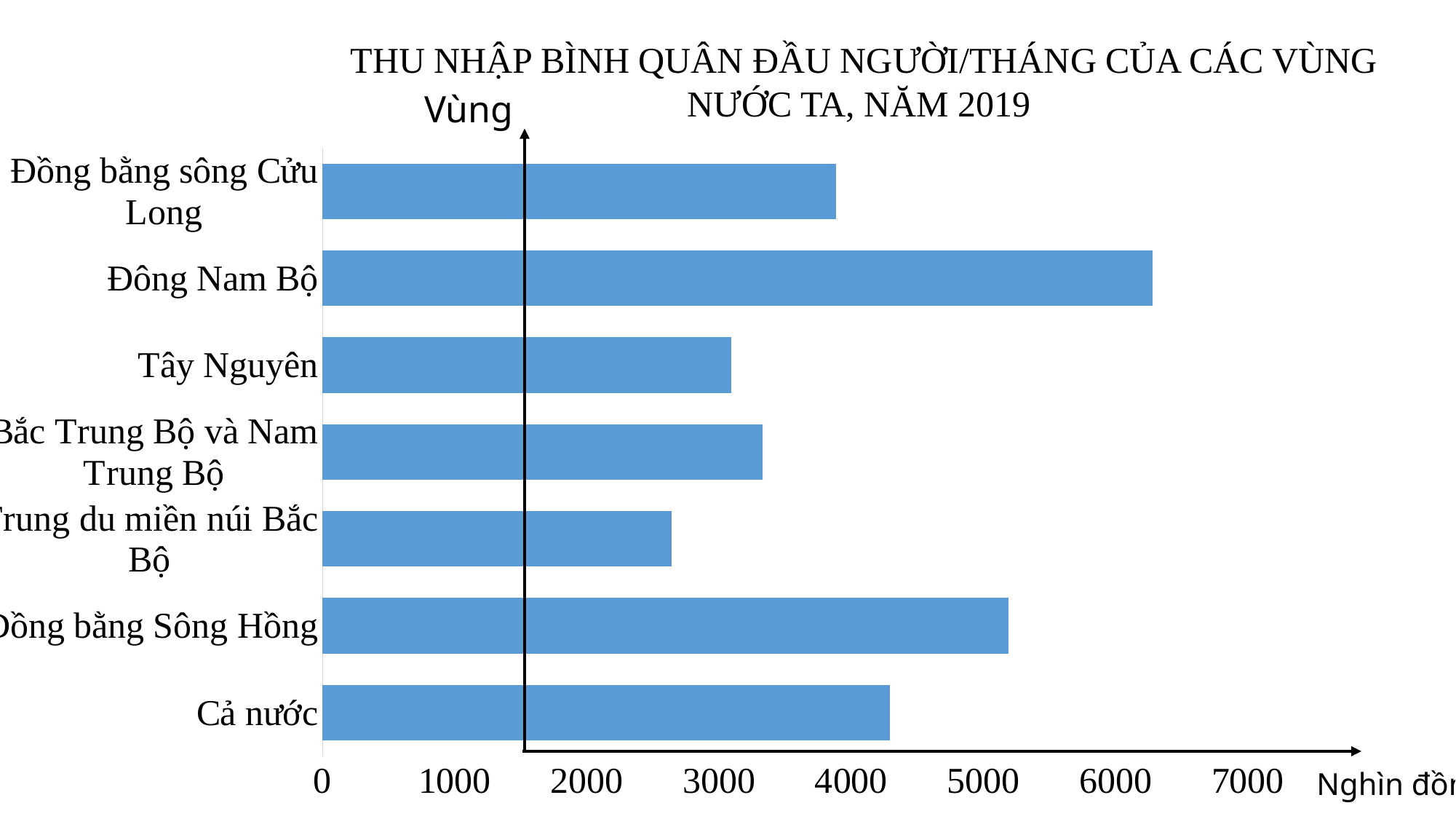
What unit is shown on the horizontal axis of the chart? Nghìn đồng Is the value for Đông Nam Bộ greater or less than 6000? greater Which region has the lowest average monthly income per person in the chart? Trung du miền núi Bắc Bộ Which region has the highest average monthly income per person in the chart? Đông Nam Bộ How many regions (bars) are shown in the chart? 7 Is the value for Tây Nguyên greater or less than 4000? less Is the value for Cả nước greater or less than 4000? greater Which is larger, the value for Đồng bằng sông Cửu Long or the value for Tây Nguyên? Đồng bằng sông Cửu Long What kind of chart is shown on the slide? Bar chart Which is larger, the value for Đồng bằng Sông Hồng or the value for Cả nước? Đồng bằng Sông Hồng